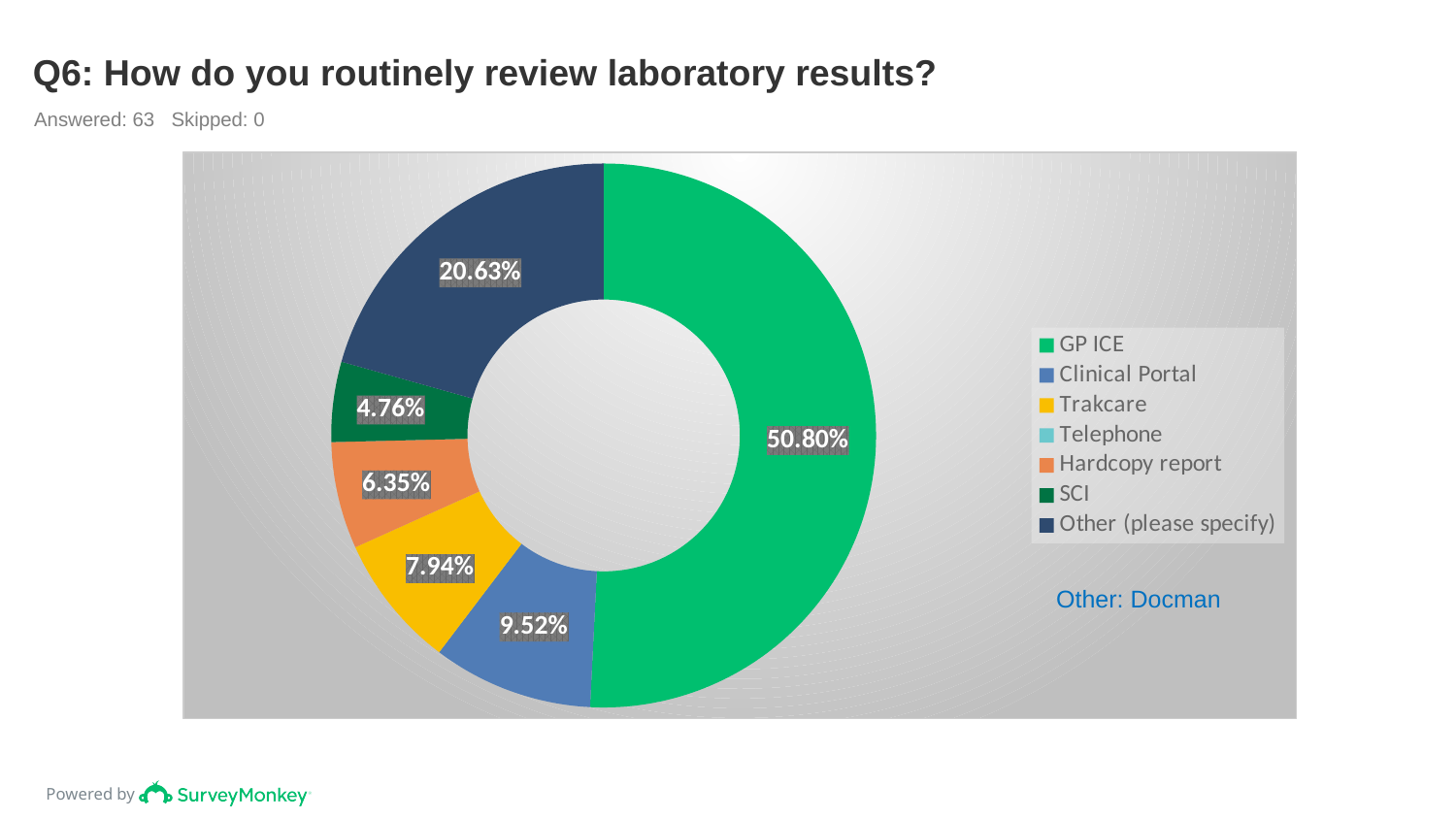
What percentage is shown for Other (please specify)? 20.63% What percentage is shown for Trakcare? 7.94% How many entries does the legend list? 7 Which category has the largest share of the pie? GP ICE What is the difference between the GP ICE share and the Other (please specify) share? 30.17% What type of chart is shown on the slide? Pie chart (donut) Which is larger, the share for Clinical Portal or the share for Trakcare? Clinical Portal Which labelled slice has the smallest share of the pie? SCI What percentage is shown for Clinical Portal? 9.52% What percentage is shown for SCI? 4.76% What percentage of respondents review laboratory results via GP ICE? 50.80% What percentage is shown for Hardcopy report? 6.35%